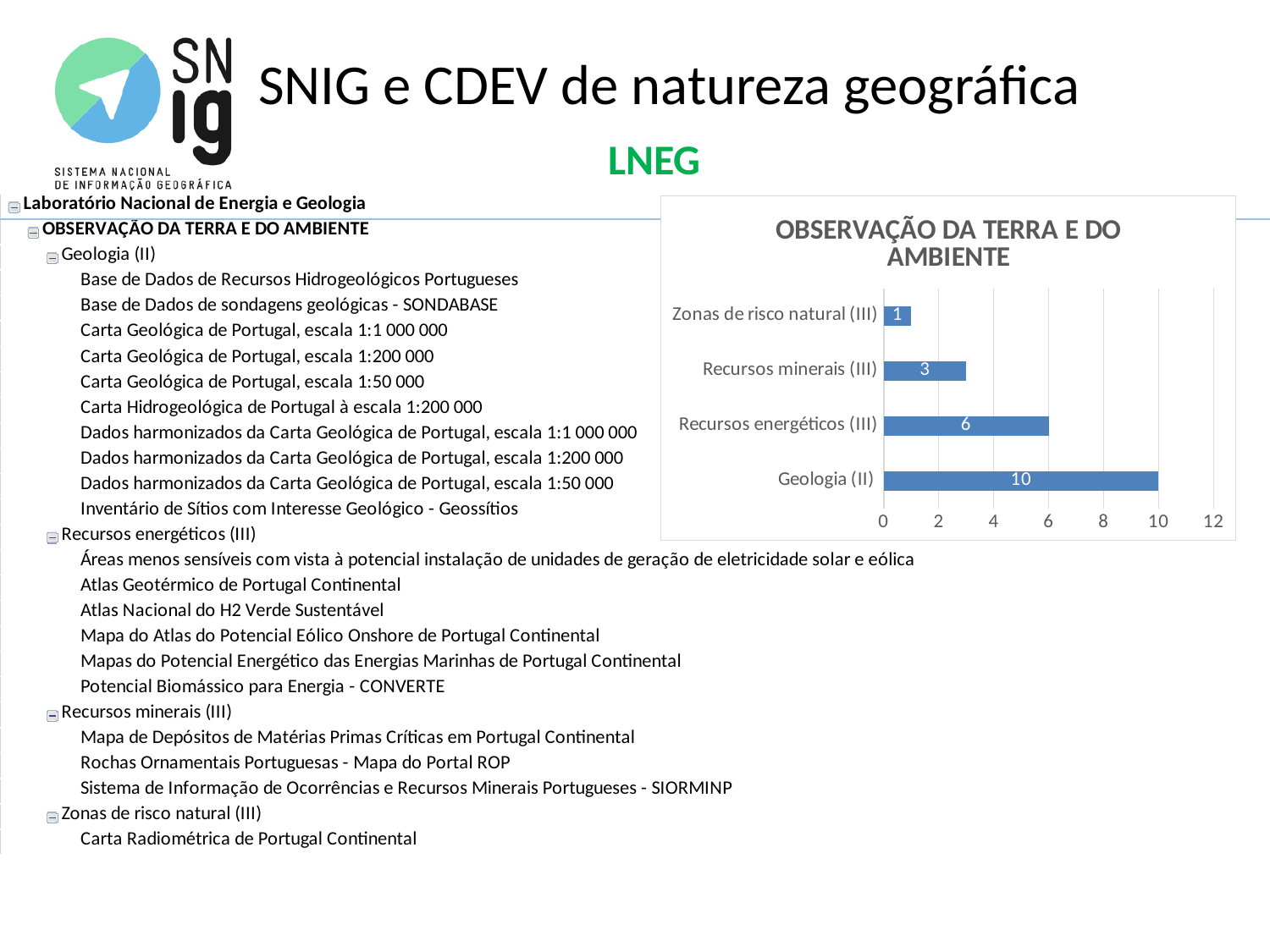
Which category has the lowest value in the chart? Zonas de risco natural (III) What is the value for Recursos minerais (III) in the chart? 3 What is the value for Recursos energéticos (III) in the chart? 6 Is the value for Geologia (II) greater or less than 8? greater What is the value for Zonas de risco natural (III) in the chart? 1 What is the value for Geologia (II) in the chart? 10 Which category has the highest value in the chart? Geologia (II) What is the title of the chart? OBSERVAÇÃO DA TERRA E DO AMBIENTE What kind of chart is shown on the slide? bar chart How many categories are shown in the chart? 4 Which is larger, the value for Recursos minerais (III) or the value for Recursos energéticos (III)? Recursos energéticos (III) What is the difference between the values for Geologia (II) and Recursos energéticos (III)? 4